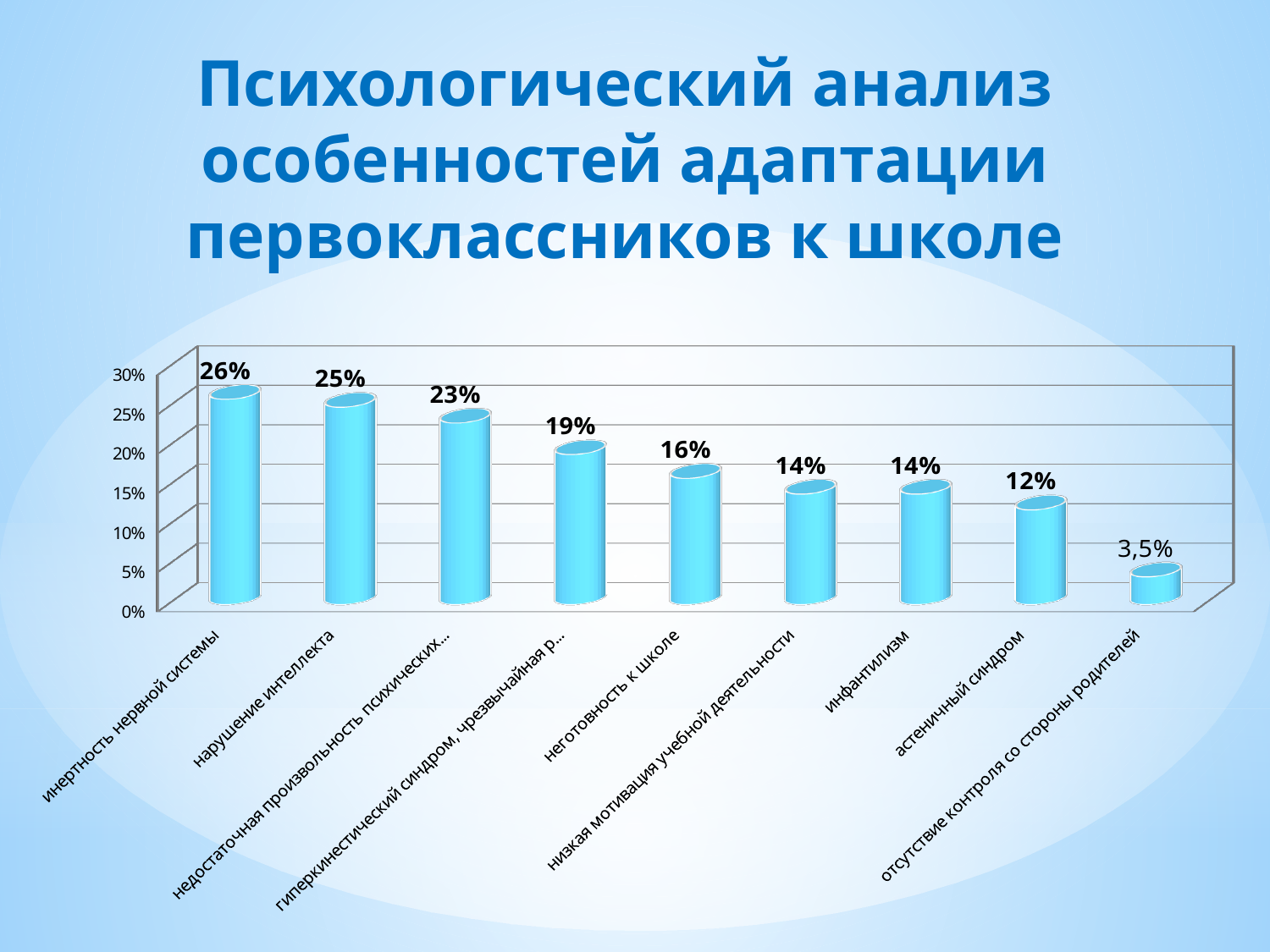
What is the value for «астеничный синдром»? 12% Which is larger: the value for «неготовность к школе» or the value for «астеничный синдром»? неготовность к школе What is the difference between the values for «нарушение интеллекта» and «инфантилизм»? 11% Which category has the lowest value? отсутствие контроля со стороны родителей What kind of chart is shown on the slide? bar chart How many categories are shown in the chart? 9 Which category has the highest value? инертность нервной системы Do the values rise or fall from left to right along the x axis? fall Is the value for «низкая мотивация учебной деятельности» greater or less than 20%? less What is the value for «отсутствие контроля со стороны родителей»? 3,5% What is the value for «инертность нервной системы»? 26% What is the value for «неготовность к школе»? 16%